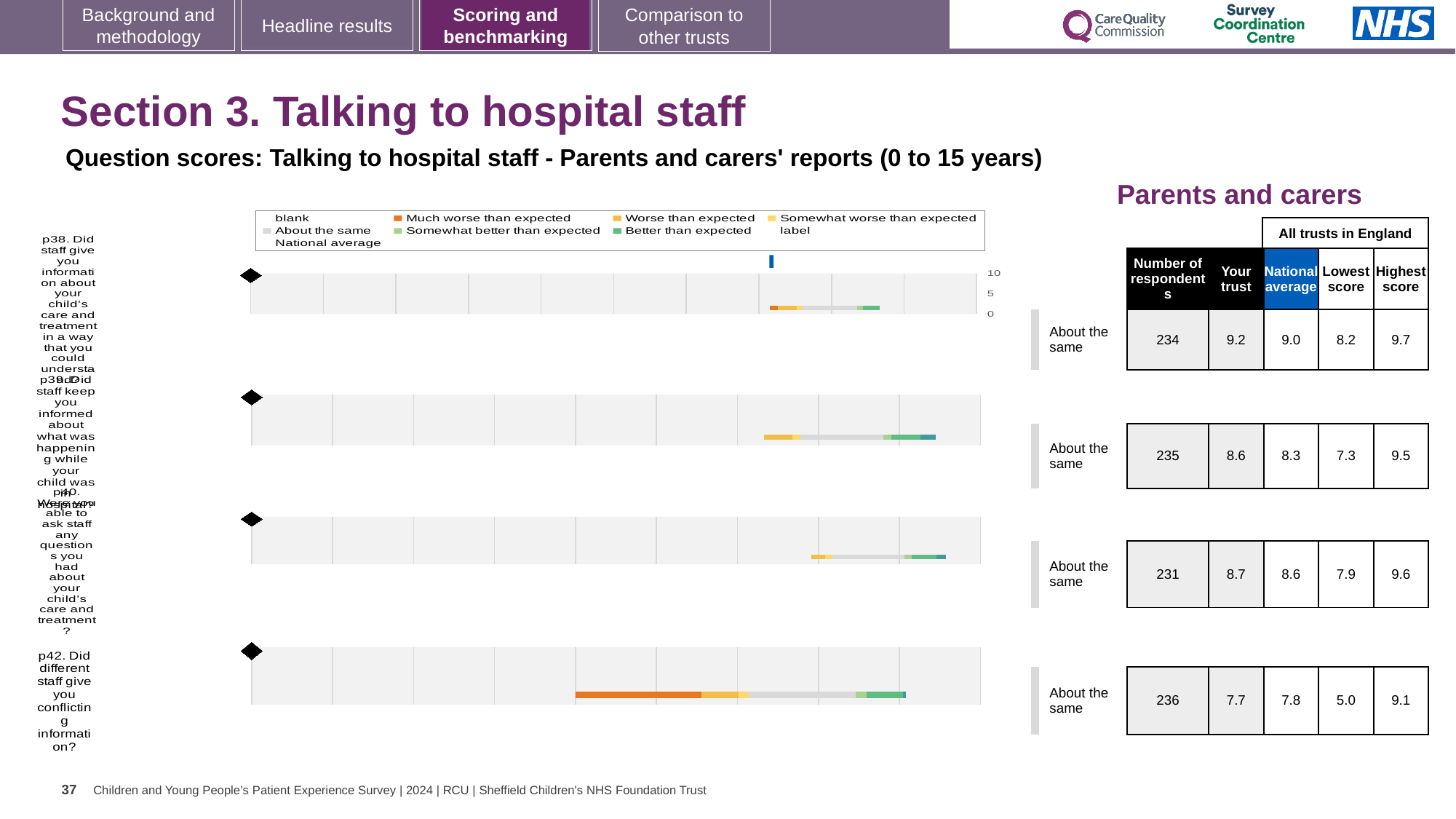
Which question has the lowest 'Your trust' score? p42 What is the 'Your trust' score for p38 (Did staff give you information about your child's care and treatment in a way that you could understand)? 9.2 In the chart legend, which colour represents 'Much worse than expected'? orange What is the lowest score across all trusts in England for p42? 5.0 For p38, is the 'Your trust' score higher or lower than the national average? higher For p42, what is the difference between the highest score and the lowest score across all trusts in England? 4.1 What is the national average score for p39 (Did staff keep you informed about what was happening while your child was in hospital)? 8.3 How many respondents answered p42 (Did different staff give you conflicting information)? 236 What benchmark category is shown next to the chart for p38? About the same How many survey questions (charts) are plotted on the slide? 4 Which question has the highest 'Your trust' score? p38 What kind of chart is used to show the question scores on this slide? bar chart